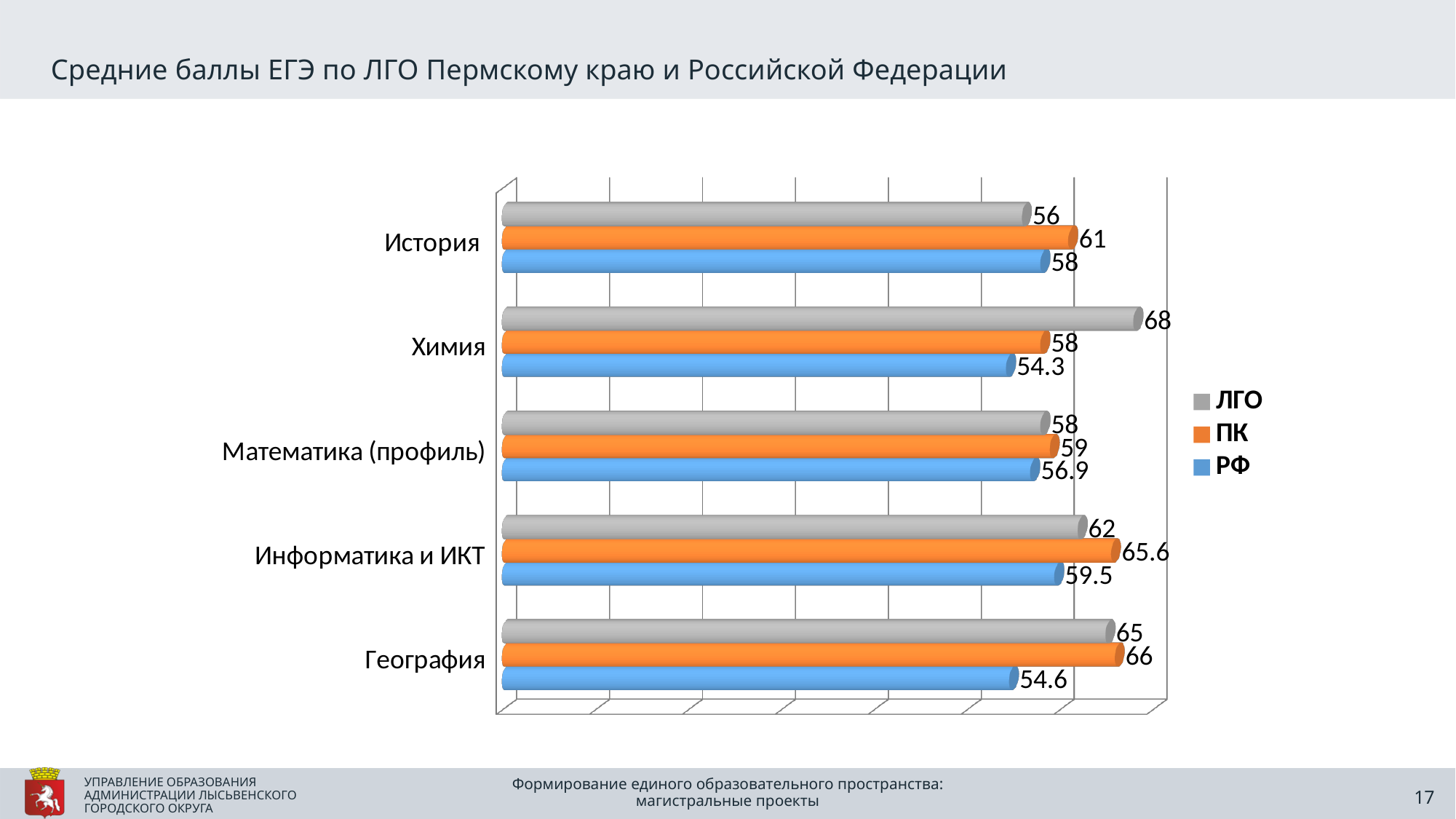
Which series is shown in orange in the legend? ПК Which is larger for История: the ПК value or the ЛГО value? ПК What type of chart is shown on the slide? Bar chart What is the РФ value for География? 54.6 Which subject has the lowest РФ value? Химия What is the ПК value for Информатика и ИКТ? 65.6 Which subject has the highest ЛГО value? Химия What is the ЛГО value for Химия? 68 What is the difference between the ПК and ЛГО values for История? 5 What is the difference between the ЛГО and РФ values for Химия? 13.7 How many subject categories are shown in the chart? 5 How many series does the legend list? 3